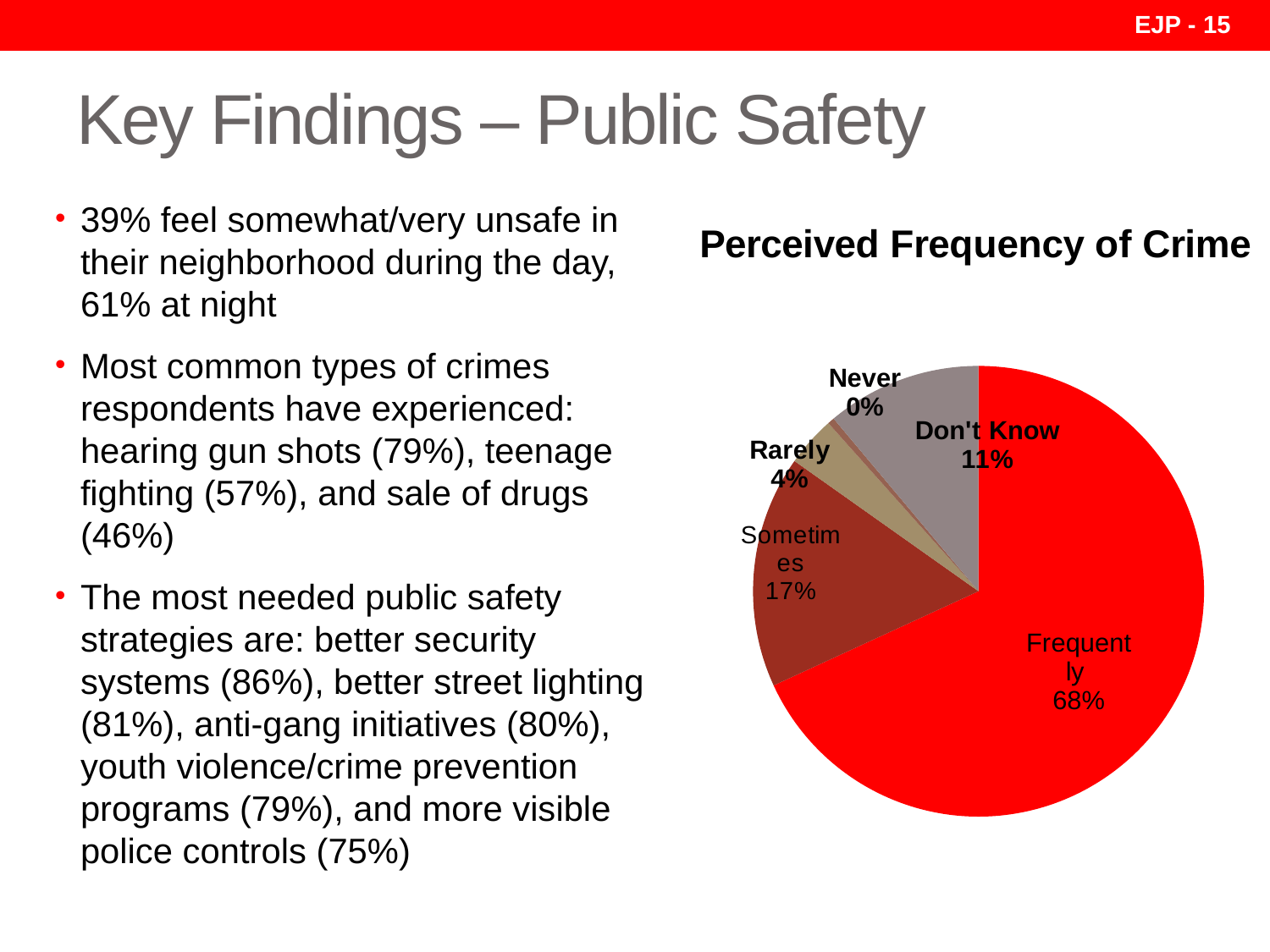
What type of chart is shown on the slide? pie chart What is the difference in percentage points between Frequently and Sometimes? 51 What share of respondents said crime occurs Rarely? 4% How many categories are shown in the pie chart? 5 What is the title of the chart? Perceived Frequency of Crime What share of respondents answered Don't Know? 11% Which is larger, the Sometimes slice or the Don't Know slice? Sometimes What share of respondents said crime occurs Frequently? 68% Which category has the smallest slice of the pie? Never What share of respondents said crime occurs Sometimes? 17% What share of respondents said crime Never occurs? 0% Which category has the largest slice of the pie? Frequently